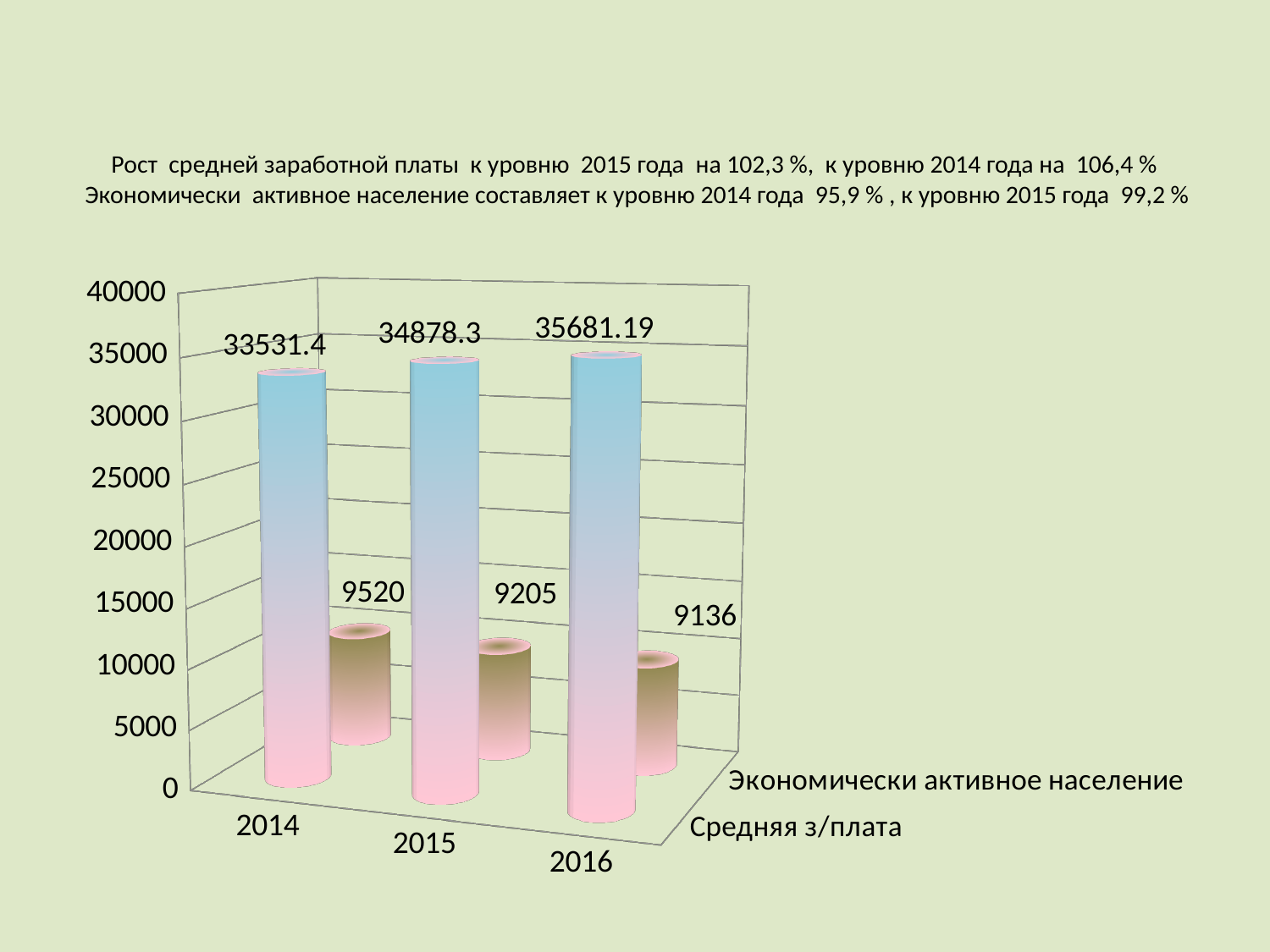
Does Экономически активное население rise or fall from 2014 to 2016? fall What is the difference between the Экономически активное население values for 2014 and 2016? 384 How many years are shown on the x axis of the chart? 3 In which year is Средняя з/плата highest? 2016 What is the value for Средняя з/плата in 2014? 33531.4 What kind of chart is shown on the slide? bar chart Which is larger: Средняя з/плата in 2015 or in 2014? 2015 What is the value for Средняя з/плата in 2016? 35681.19 What is the value for Экономически активное население in 2016? 9136 Does Средняя з/плата rise or fall from 2014 to 2016? rise In which year is Экономически активное население lowest? 2016 What is the value for Экономически активное население in 2015? 9205